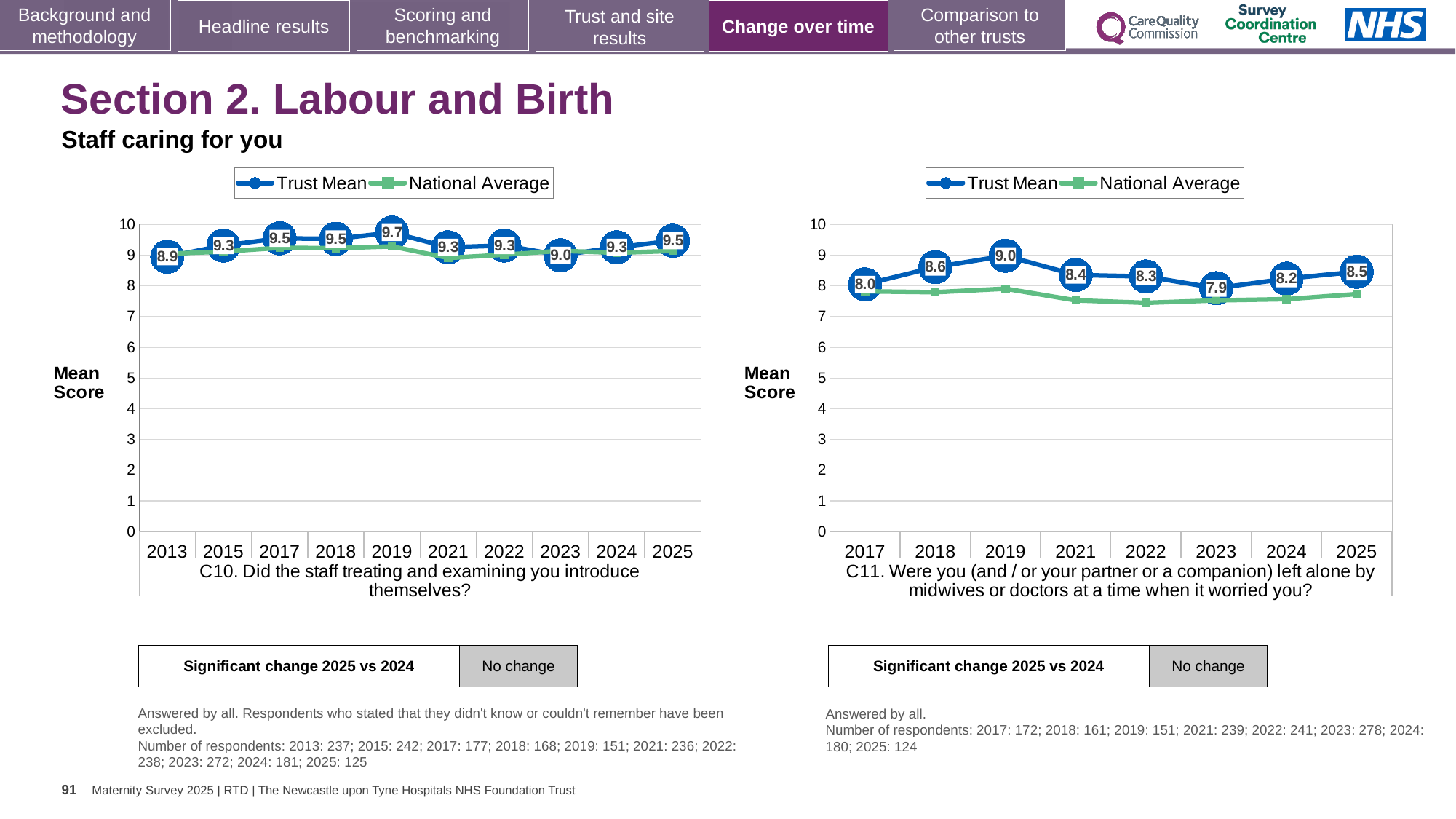
In the C10 chart, what is the Trust Mean score for 2019? 9.7 In the C11 chart, which year has the highest Trust Mean score? 2019 How many years are plotted on the x axis of the C10 chart? 10 In the C11 chart, which year has the lowest Trust Mean score? 2023 In the C11 chart, what is the Trust Mean score for 2023? 7.9 In the C10 chart, which year has the lowest Trust Mean score? 2013 In the C10 chart, is the Trust Mean score higher in 2025 or in 2023? 2025 How many series does the legend of the C11 chart list? 2 What type of chart is the C11 chart? Line chart In the C10 chart, what is the Trust Mean score for 2013? 8.9 In the C11 chart, is the National Average value for 2022 greater or less than 8? less In the C11 chart, what is the difference between the Trust Mean scores for 2019 and 2017? 1.0